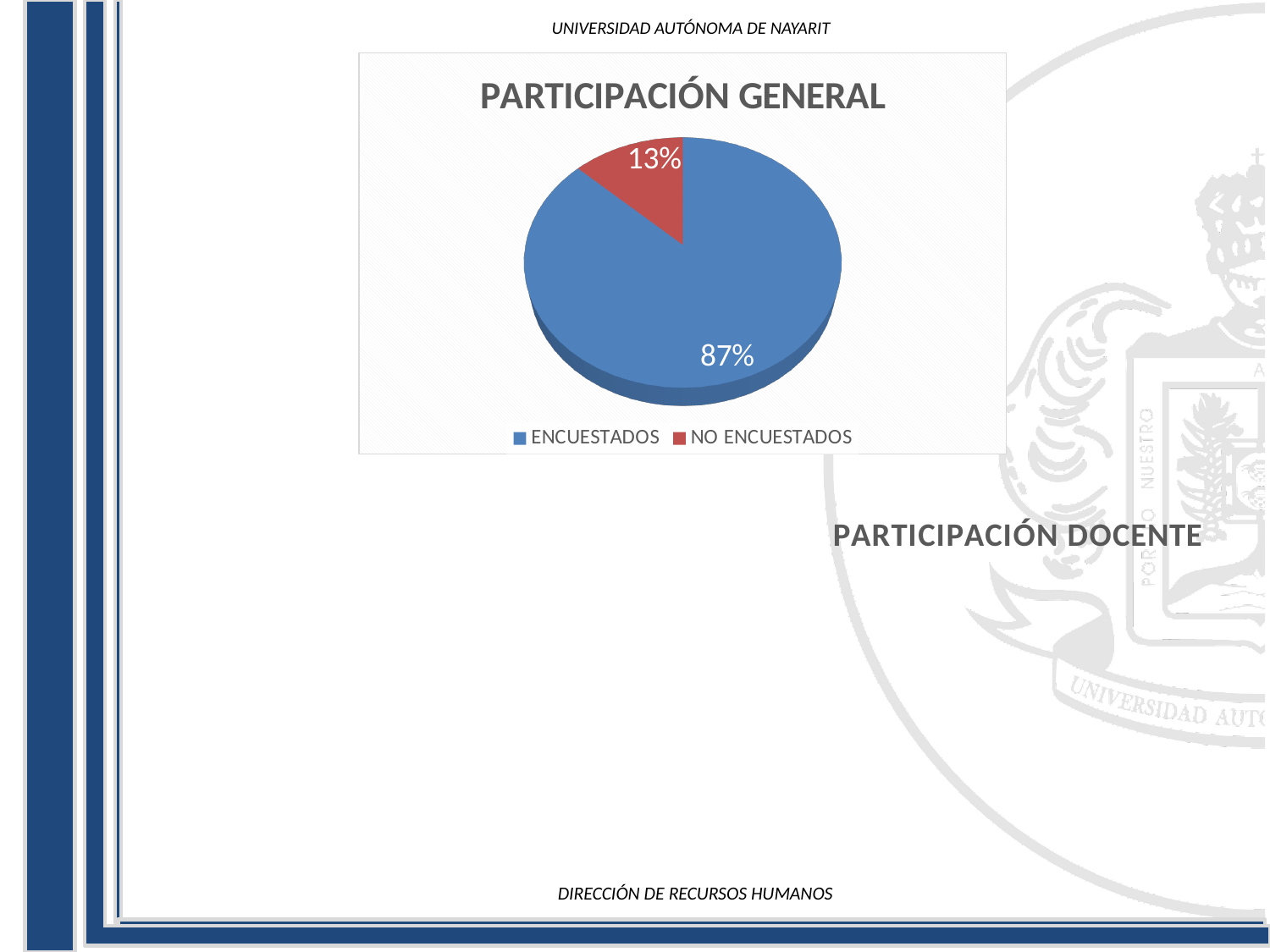
What colour is the NO ENCUESTADOS slice? Red Which category has the largest slice of the pie? ENCUESTADOS What share of the pie does ENCUESTADOS represent? 87% What share of the pie does NO ENCUESTADOS represent? 13% Which category has the smallest slice of the pie? NO ENCUESTADOS How many slices does the pie chart have? 2 Which is larger, the ENCUESTADOS slice or the NO ENCUESTADOS slice? ENCUESTADOS What kind of chart is shown on the slide? Pie chart How many entries does the legend list? 2 What is the title of the chart? PARTICIPACIÓN GENERAL What is the difference in percentage points between ENCUESTADOS and NO ENCUESTADOS? 74